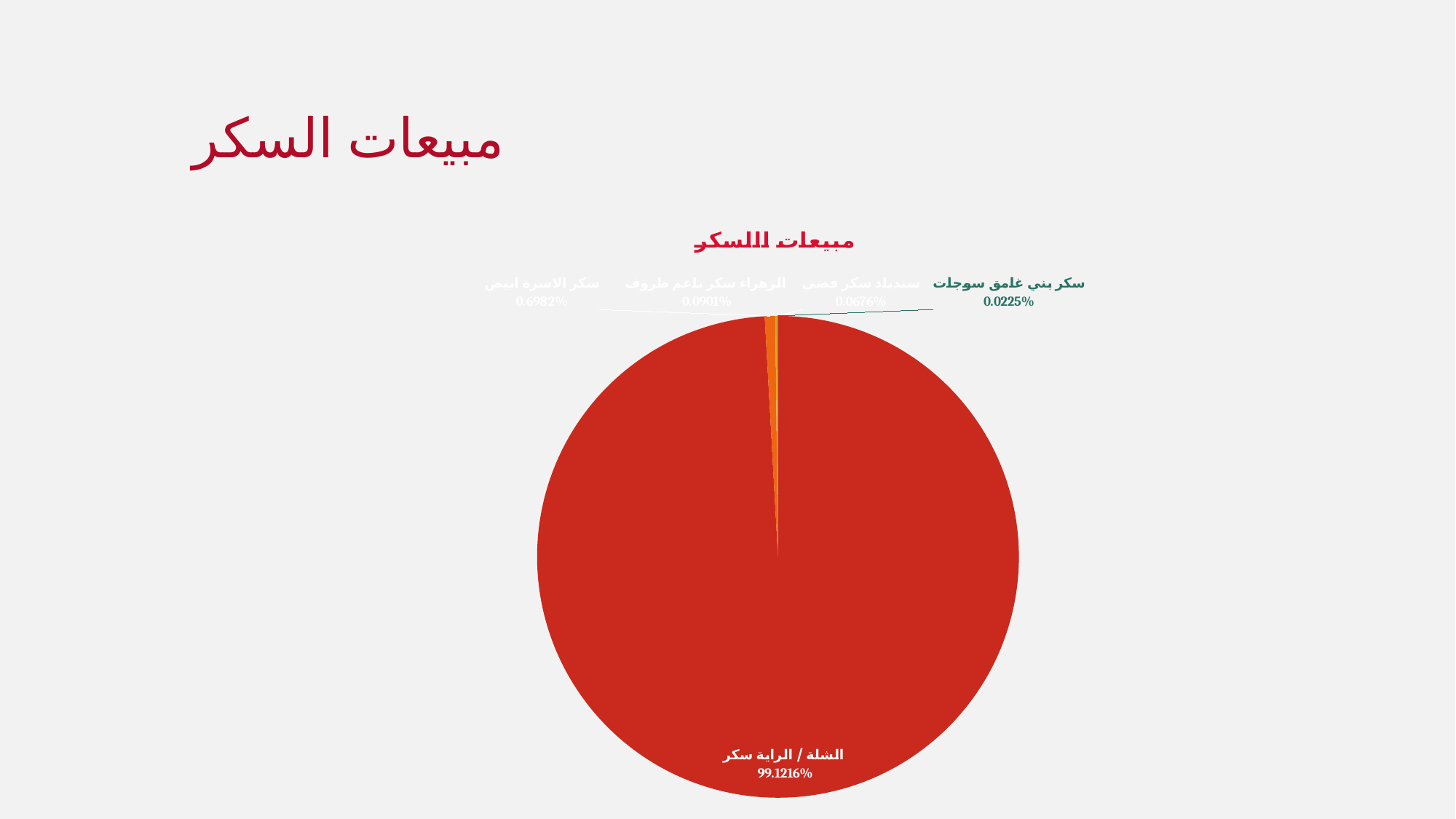
What share of the pie does سندباد سكر فضي have? 0.0676% What kind of chart is shown on the slide? pie chart Which has a larger share, سكر الاسرة ابيض or الزهراء سكر ناعم ظروف? سكر الاسرة ابيض What is the difference in share between سندباد سكر فضي and سكر بني غامق سوجات? 0.0451% Which category has the smallest share of the pie? سكر بني غامق سوجات What is the title of the chart? مبيعات االسكر What share of the pie does سكر بني غامق سوجات have? 0.0225% What share of the pie does الزهراء سكر ناعم ظروف have? 0.0901% Which category has the largest share of the pie? الشلة / الراية سكر What share of the pie does سكر الاسرة ابيض have? 0.6982% What share of the pie does الشلة / الراية سكر have? 99.1216% How many slices does the pie chart have? 5